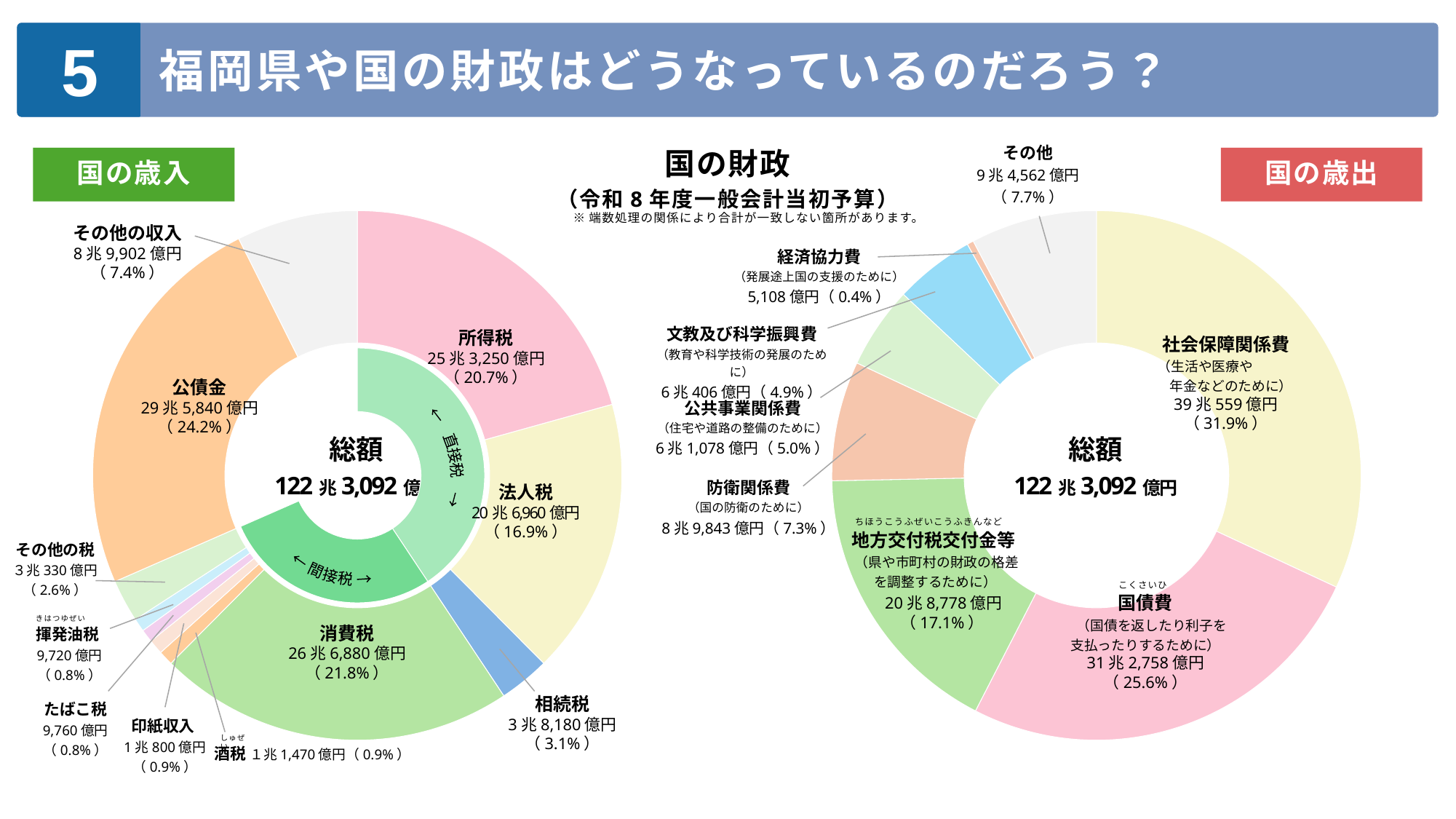
In the 国の歳入 chart on the left, what is the value shown for 消費税? 26兆6,880億円（21.8%） In the 国の歳出 chart on the right, which category has the smallest share? 経済協力費 In the 国の歳出 chart on the right, what is the percentage share of 国債費? 25.6% How many categories are shown in the 国の歳出 chart on the right? 8 What total amount is shown in the centre of the 国の歳出 chart on the right? 122兆3,092億円 In the 国の歳入 chart on the left, which is larger: 所得税 or 法人税? 所得税 In the 国の歳出 chart on the right, what is the difference in percentage points between 社会保障関係費 (31.9%) and 国債費 (25.6%)? 6.3 In the 国の歳出 chart on the right, what is the value shown for 社会保障関係費? 39兆559億円（31.9%） What type of chart is used for 国の歳入 on the left? Donut (pie) chart In the 国の歳入 chart on the left, which category has the largest share? 公債金 What is the subtitle shown under 国の財政 between the two charts? （令和8年度一般会計当初予算） In the 国の歳入 chart on the left, what is the value shown for 相続税? 3兆8,180億円（3.1%）